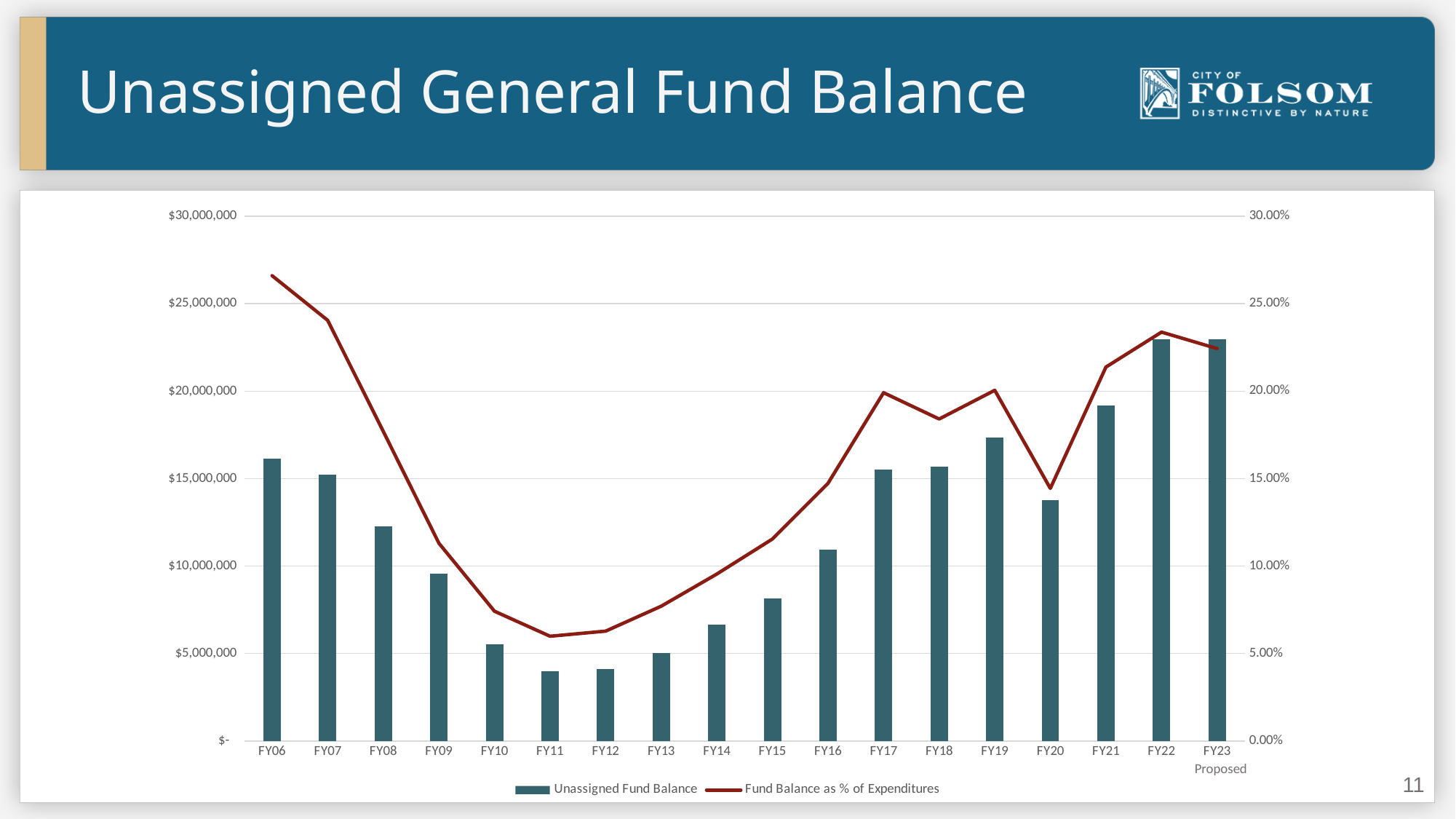
How many fiscal years are shown on the x axis of the chart? 18 Is the Fund Balance as % of Expenditures value for FY20 greater or less than 15.00%? less Which fiscal year has the highest Fund Balance as % of Expenditures? FY06 What kind of chart is shown on the slide? A combined bar and line chart Is the Unassigned Fund Balance bar for FY20 greater or less than $15,000,000? less How many series does the chart's legend list? 2 Which has the larger Unassigned Fund Balance bar, FY19 or FY20? FY19 Is the Fund Balance as % of Expenditures value for FY06 greater or less than 25.00%? greater Which has the larger Unassigned Fund Balance bar, FY08 or FY09? FY08 Do the Unassigned Fund Balance bars rise or fall from FY06 to FY11? fall